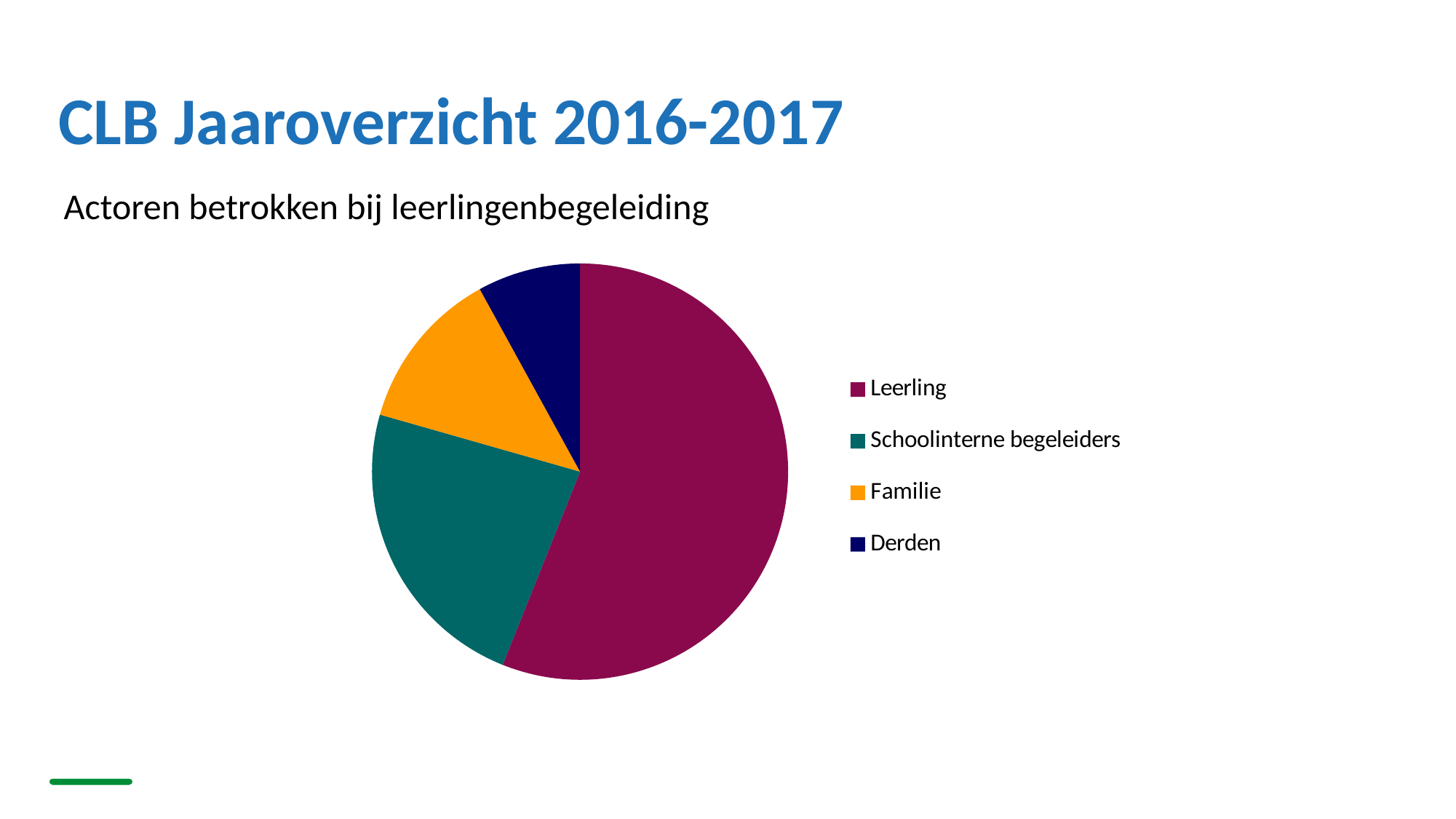
Which category has the smallest slice of the pie chart? Derden What kind of chart is shown on the slide? pie chart Which category has the largest slice of the pie chart? Leerling Which slice is larger: Leerling or Schoolinterne begeleiders? Leerling Does the Leerling slice make up more or less than half of the pie? more What colour is the Familie slice in the pie chart? orange How many entries does the legend of the pie chart list? 4 Which slice is larger: Familie or Derden? Familie What is the subtitle describing the pie chart? Actoren betrokken bij leerlingenbegeleiding How many categories (slices) does the pie chart have? 4